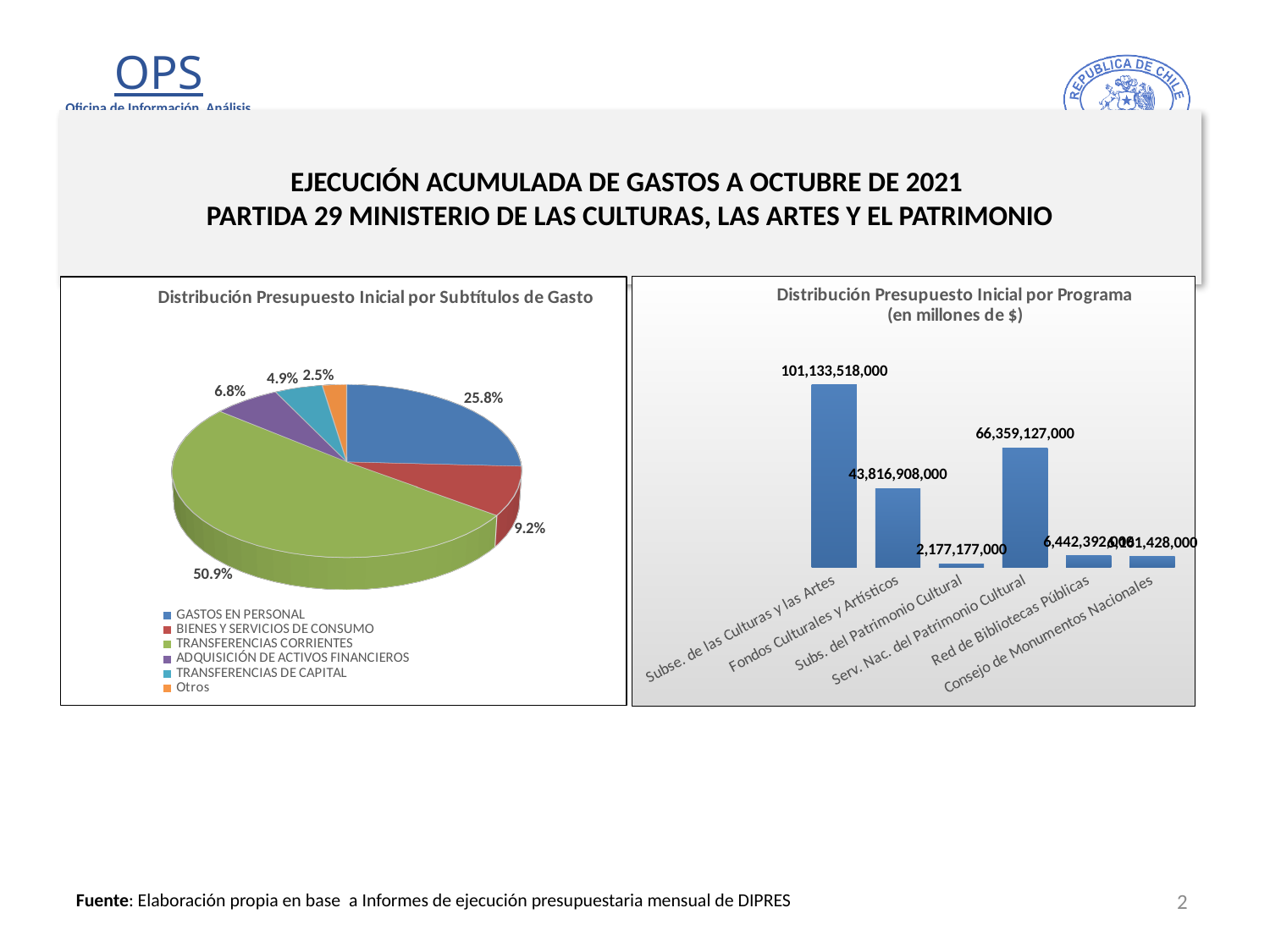
In the bar chart 'Distribución Presupuesto Inicial por Programa', what is the value for Fondos Culturales y Artísticos? 43,816,908,000 In the bar chart 'Distribución Presupuesto Inicial por Programa', which program has the lowest value? Subs. del Patrimonio Cultural What kind of chart is the one on the left of the slide? Pie chart In the bar chart 'Distribución Presupuesto Inicial por Programa', what is the value for Subse. de las Culturas y las Artes? 101,133,518,000 In the pie chart 'Distribución Presupuesto Inicial por Subtítulos de Gasto', which category has the largest slice? TRANSFERENCIAS CORRIENTES In the pie chart 'Distribución Presupuesto Inicial por Subtítulos de Gasto', what is the difference in percentage points between GASTOS EN PERSONAL and BIENES Y SERVICIOS DE CONSUMO? 16.6 percentage points In the bar chart 'Distribución Presupuesto Inicial por Programa', which is larger: Fondos Culturales y Artísticos or Serv. Nac. del Patrimonio Cultural? Serv. Nac. del Patrimonio Cultural In the pie chart 'Distribución Presupuesto Inicial por Subtítulos de Gasto', which category has the smallest slice? Otros In the pie chart 'Distribución Presupuesto Inicial por Subtítulos de Gasto', how many categories does the legend list? 6 In the pie chart 'Distribución Presupuesto Inicial por Subtítulos de Gasto', what share does TRANSFERENCIAS CORRIENTES have? 50.9% In the pie chart 'Distribución Presupuesto Inicial por Subtítulos de Gasto', what is the percentage for GASTOS EN PERSONAL? 25.8% In the bar chart 'Distribución Presupuesto Inicial por Programa', what is the difference between Subse. de las Culturas y las Artes and Serv. Nac. del Patrimonio Cultural? 34,774,391,000